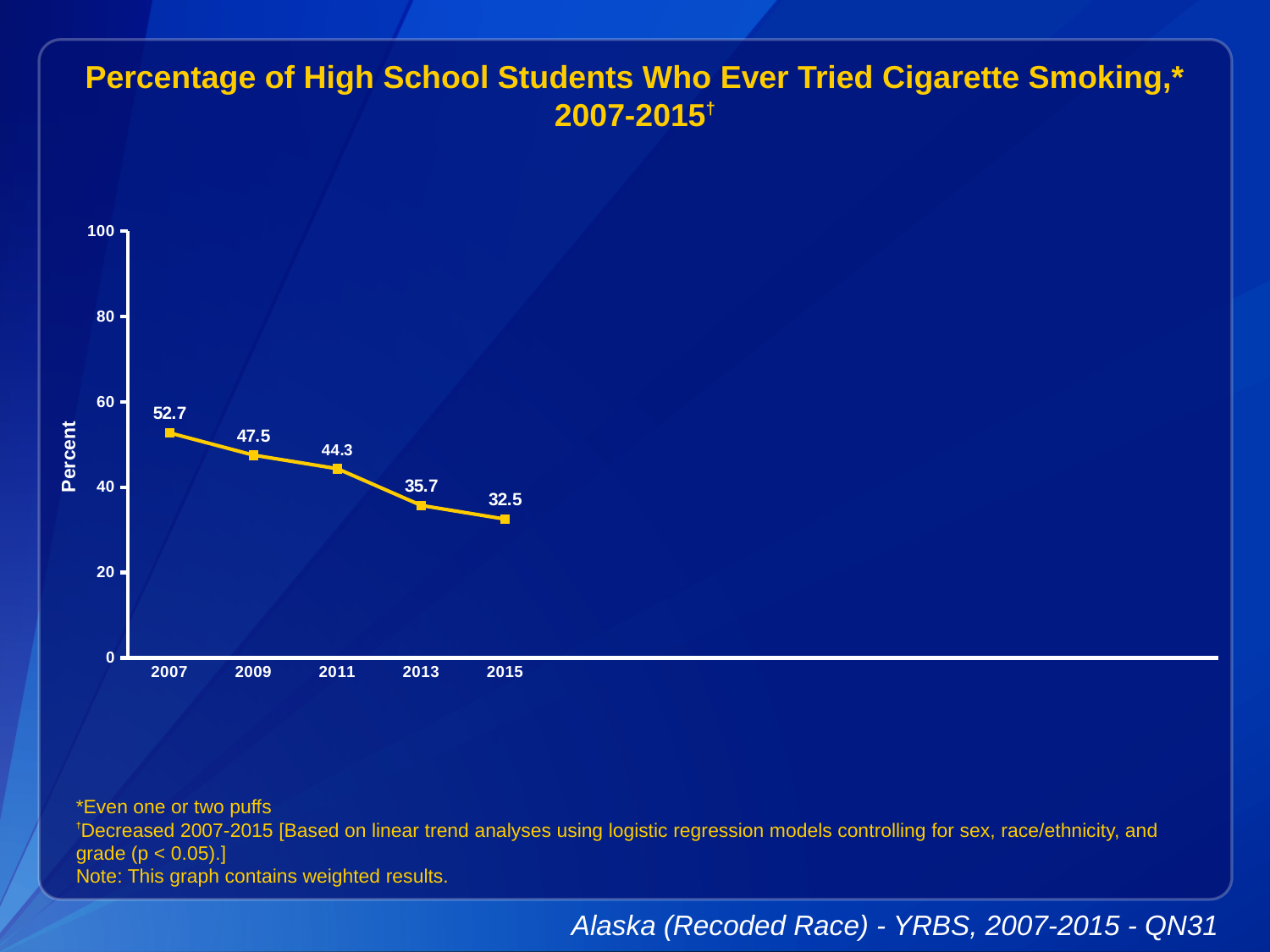
Is the value for 2013 greater or less than 40? less Which year has the highest percentage? 2007 What is the difference between the 2007 value and the 2015 value? 20.2 What percentage of high school students had ever tried cigarette smoking in 2007? 52.7 What is the value plotted for 2015? 32.5 What kind of chart is shown on the slide? line chart Do the values rise or fall from 2007 to 2015? fall Which year has the lowest percentage? 2015 How many years are plotted on the chart? 5 Which is larger, the value for 2009 or the value for 2013? 2009 What is the difference between the 2011 value and the 2013 value? 8.6 What is the value plotted for 2011? 44.3